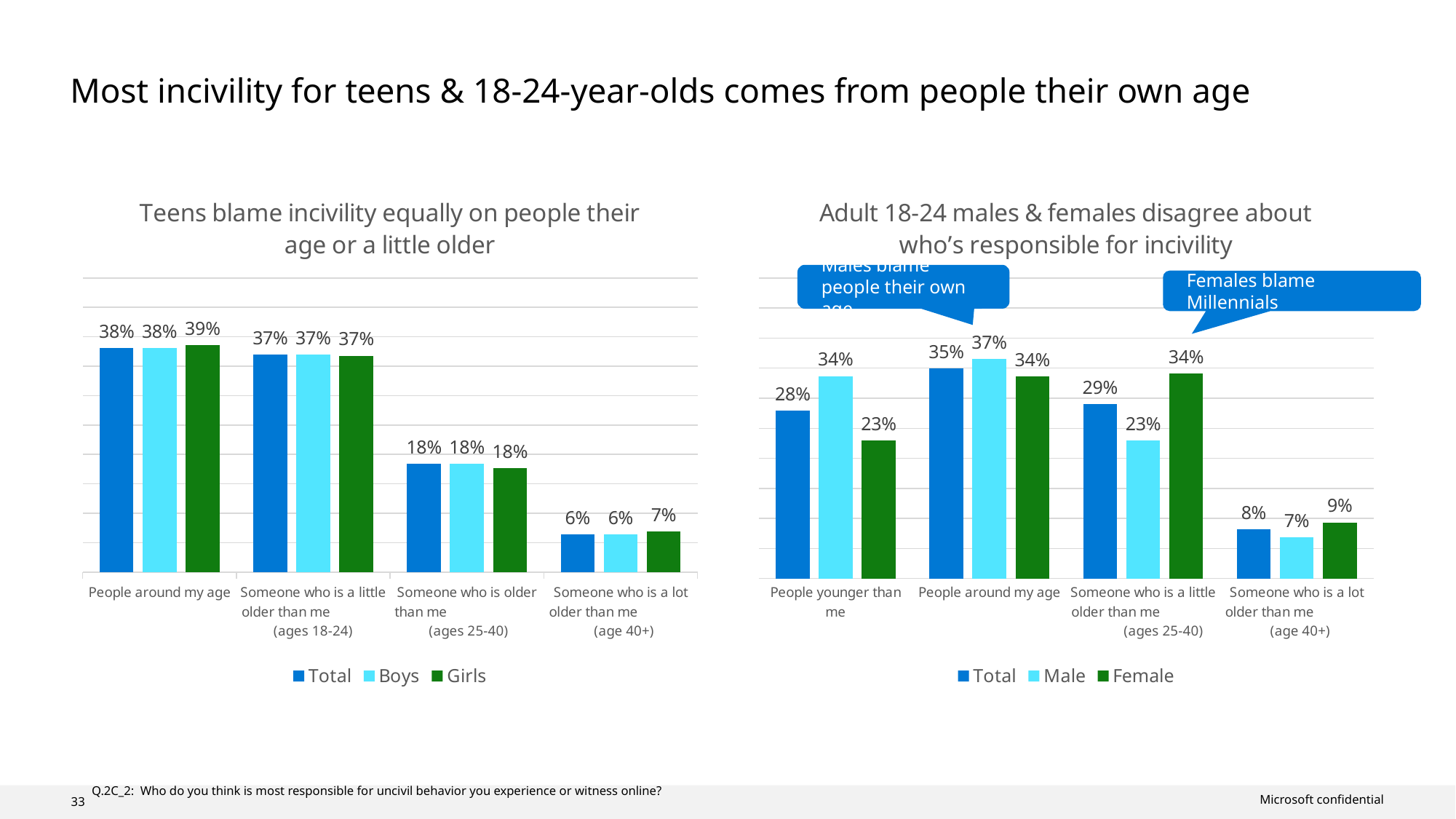
In the right chart (Adult 18-24 males & females disagree about who's responsible for incivility), which category has the lowest Total value? Someone who is a lot older than me (age 40+) In the left chart (Teens blame incivility equally on people their age or a little older), what is the Total value for "Someone who is older than me (ages 25-40)"? 18% In the left chart (Teens blame incivility equally on people their age or a little older), which category has the highest Girls value? People around my age What are the legend entries of the left chart (Teens blame incivility equally on people their age or a little older)? Total, Boys, Girls What kind of chart is the left chart (Teens blame incivility equally on people their age or a little older)? Bar chart In the left chart (Teens blame incivility equally on people their age or a little older), what is the Girls value for "People around my age"? 39% In the right chart (Adult 18-24 males & females disagree about who's responsible for incivility), which is larger for "Someone who is a little older than me (ages 25-40)": the Male value or the Female value? Female In the right chart (Adult 18-24 males & females disagree about who's responsible for incivility), what is the difference between the Male and Female values for "People younger than me"? 11% How many series does the legend of the right chart (Adult 18-24 males & females disagree about who's responsible for incivility) list? 3 In the right chart (Adult 18-24 males & females disagree about who's responsible for incivility), what is the Female value for "People younger than me"? 23% In the right chart (Adult 18-24 males & females disagree about who's responsible for incivility), what is the Male value for "People around my age"? 37% How many categories are shown on the x axis of the left chart (Teens blame incivility equally on people their age or a little older)? 4